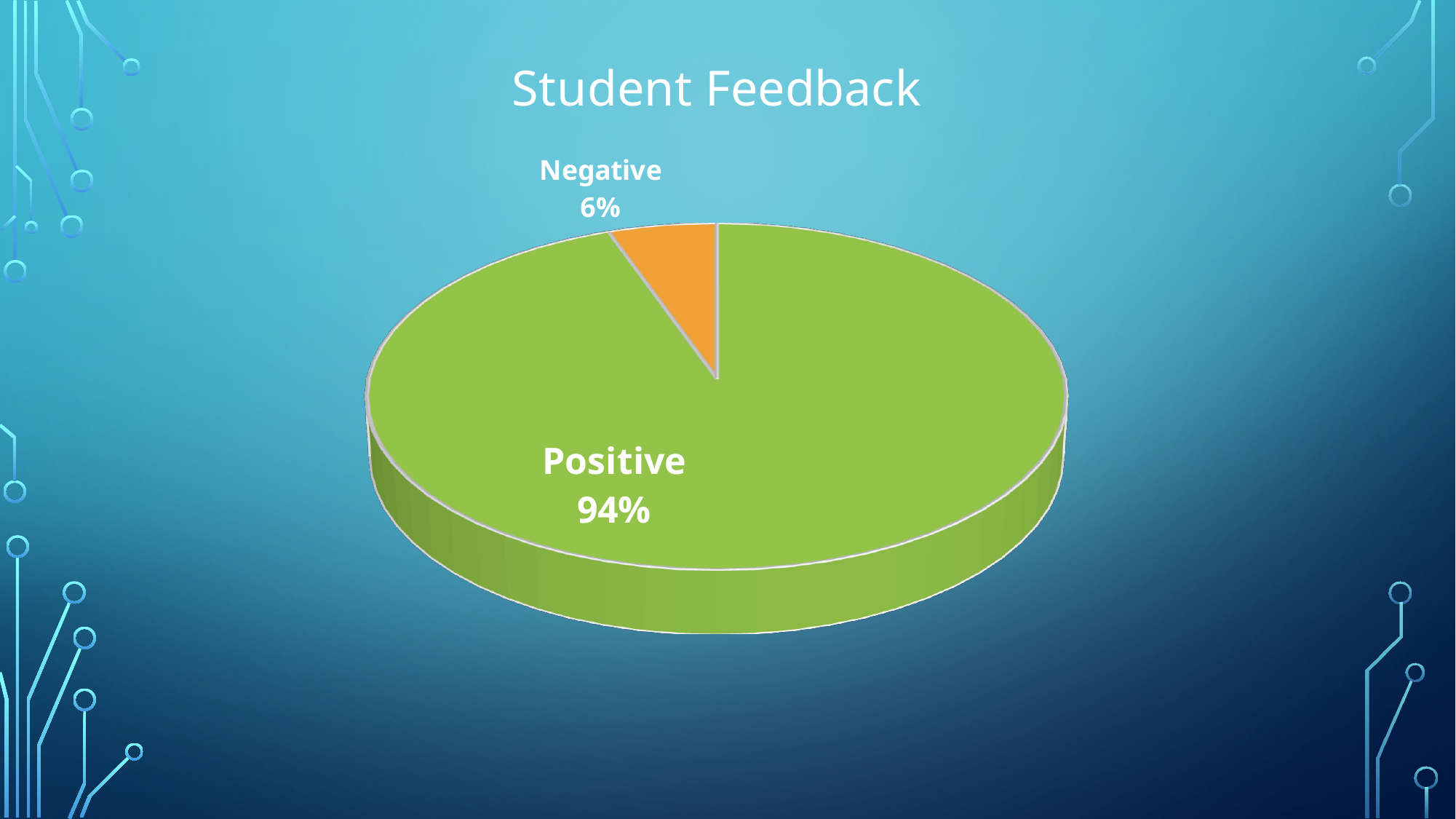
Which category has the largest share of the pie? Positive Which is larger, the Positive share or the Negative share? Positive What kind of chart is shown on the slide? Pie chart What is the difference in percentage points between the Positive and Negative shares? 88 What share of student feedback is Negative? 6% Which category has the smallest share of the pie? Negative What colour is the Negative slice? Orange What share of student feedback is Positive? 94% What is the title of the chart? Student Feedback How many categories are shown in the pie chart? 2